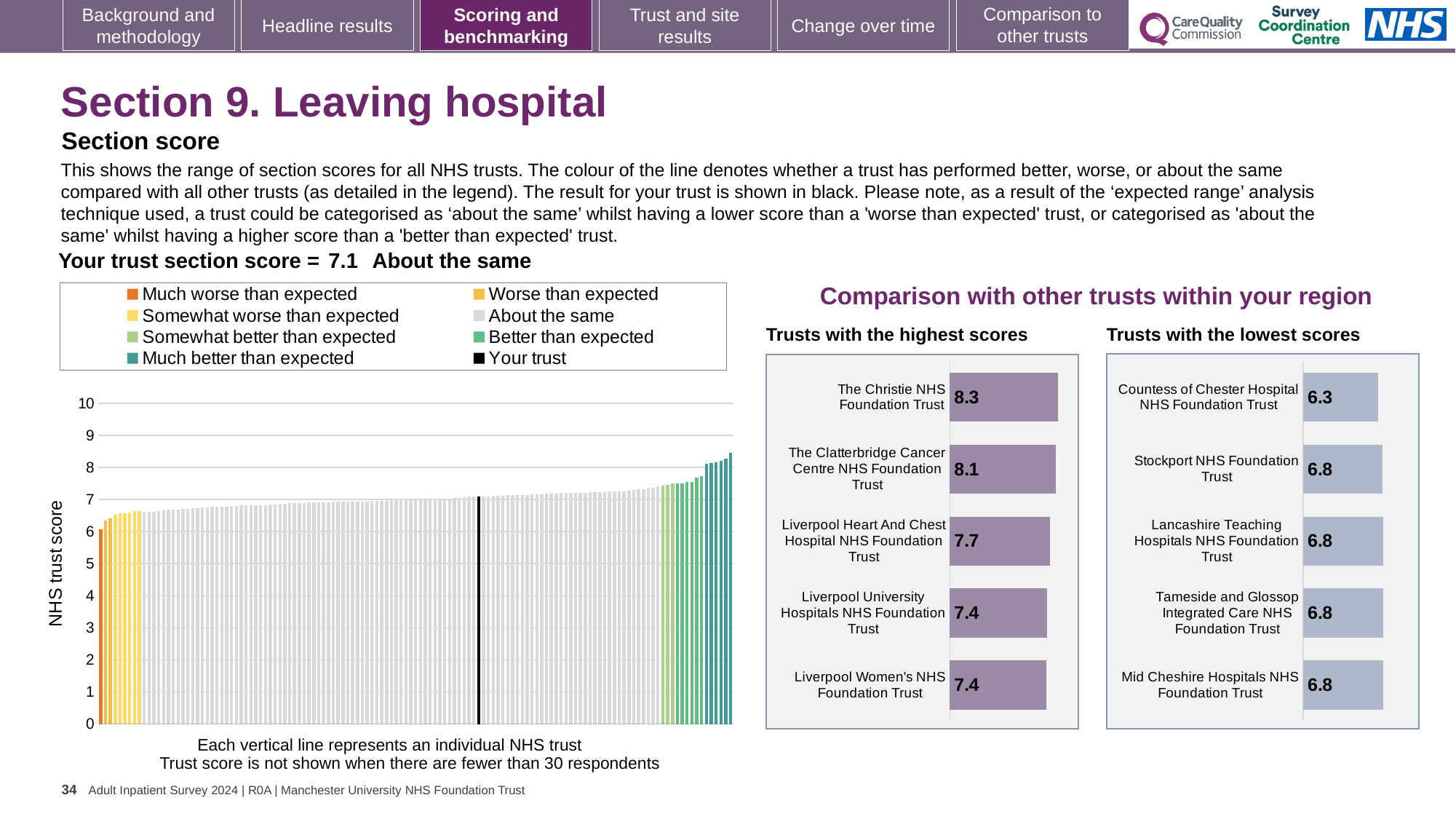
In the 'Trusts with the highest scores' chart, which trust has the highest score? The Christie NHS Foundation Trust In the 'Trusts with the highest scores' chart, which has the higher score: Liverpool Heart And Chest Hospital NHS Foundation Trust or Liverpool University Hospitals NHS Foundation Trust? Liverpool Heart And Chest Hospital NHS Foundation Trust In the 'Trusts with the lowest scores' chart, what is the difference between the scores of Stockport NHS Foundation Trust and Countess of Chester Hospital NHS Foundation Trust? 0.5 In the 'Trusts with the lowest scores' chart, what is the score for Countess of Chester Hospital NHS Foundation Trust? 6.3 How many trusts are shown in the 'Trusts with the highest scores' chart? 5 In the 'Trusts with the highest scores' chart, what is the difference between the scores of The Christie NHS Foundation Trust and The Clatterbridge Cancer Centre NHS Foundation Trust? 0.2 In the 'Trusts with the highest scores' chart, what is the score for The Christie NHS Foundation Trust? 8.3 In the 'NHS trust score' chart on the left, do the values rise or fall from left to right? Rise How many trusts are shown in the 'Trusts with the lowest scores' chart? 5 In the 'Trusts with the lowest scores' chart, which trust has the lowest score? Countess of Chester Hospital NHS Foundation Trust How many entries does the legend above the 'NHS trust score' chart list? 8 What kind of chart is the 'NHS trust score' chart on the left of the slide? Bar chart